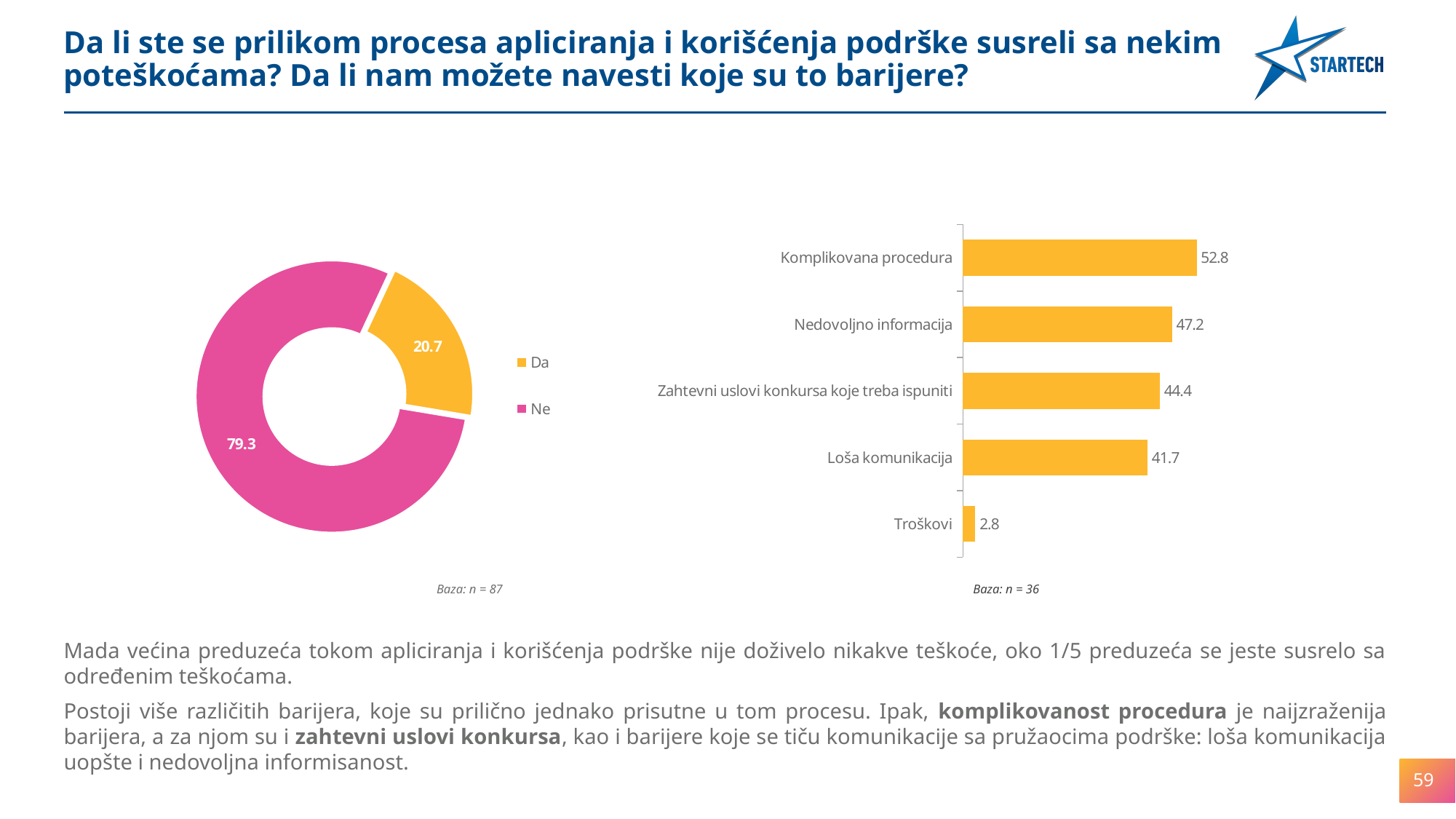
In the donut chart on the left, which slice is larger, "Da" or "Ne"? Ne What kind of chart is shown on the right of the slide? Bar chart In the bar chart on the right, which category has the highest value? Komplikovana procedura In the donut chart on the left, what is the value for "Da"? 20.7 How many entries does the legend of the donut chart on the left list? 2 In the bar chart on the right, what is the difference between "Nedovoljno informacija" and "Zahtevni uslovi konkursa koje treba ispuniti"? 2.8 How many categories are shown in the bar chart on the right? 5 What kind of chart is shown on the left of the slide? Donut (pie) chart In the bar chart on the right, what is the value for "Loša komunikacija"? 41.7 In the donut chart on the left, what is the value for "Ne"? 79.3 In the bar chart on the right, which category has the lowest value? Troškovi In the bar chart on the right, what is the value for "Komplikovana procedura"? 52.8